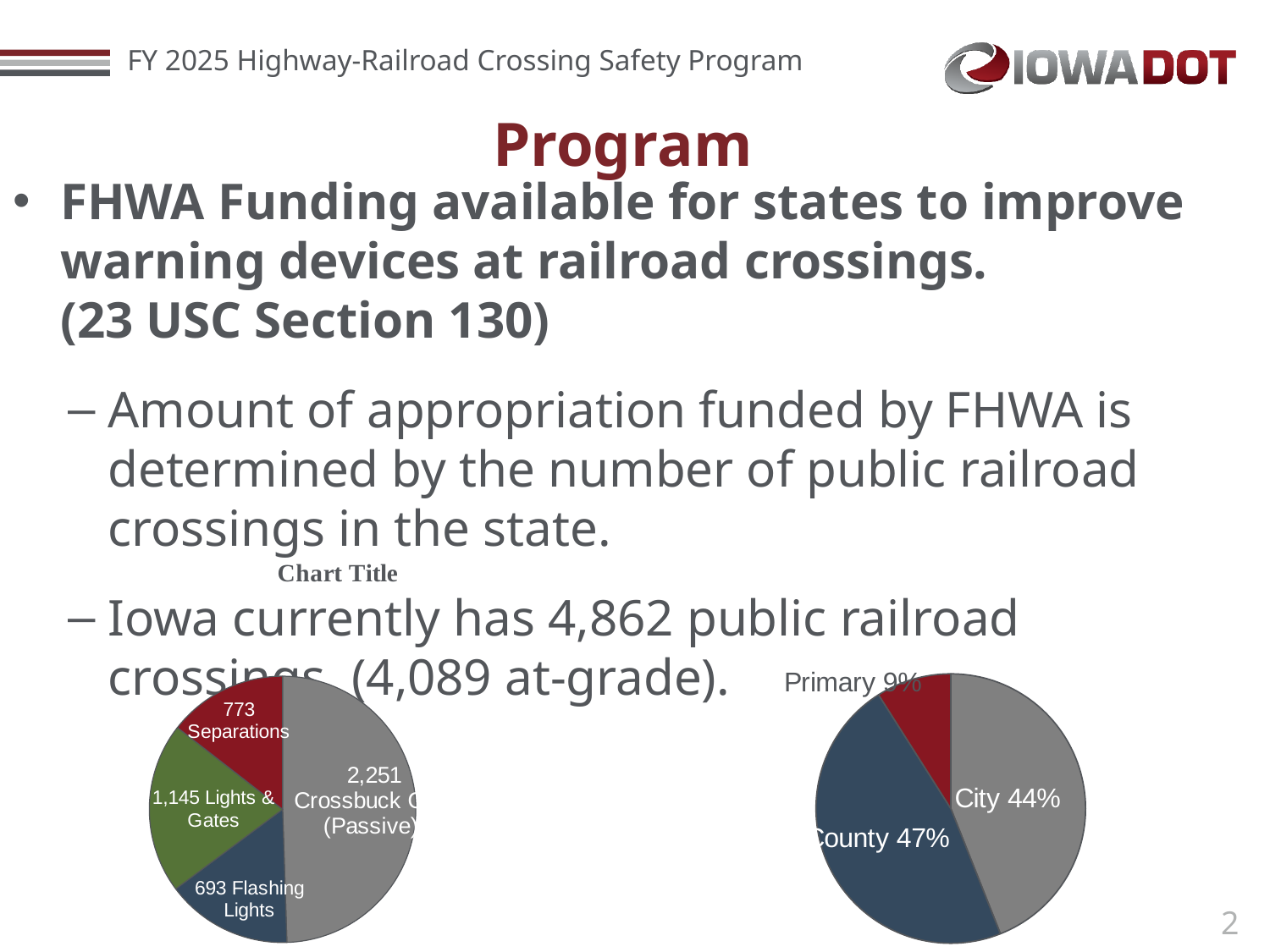
On the right pie chart, what percentage is shown for City? 44% On the left pie chart, how many crossings are labelled as Flashing Lights? 693 On the left pie chart, what is the difference between the Lights & Gates value and the Separations value? 372 On the right pie chart, which category has the smallest share? Primary What type of chart is the chart on the right of the slide? Pie chart How many slices does the right pie chart have? 3 On the left pie chart, what is the value shown for Lights & Gates? 1,145 On the left pie chart, which category has the smallest slice? Flashing Lights On the right pie chart, what percentage is shown for County? 47% How many slices does the left pie chart have? 4 On the left pie chart, what is the value shown for Separations? 773 On the left pie chart, which category has the largest slice? Crossbuck (Passive)